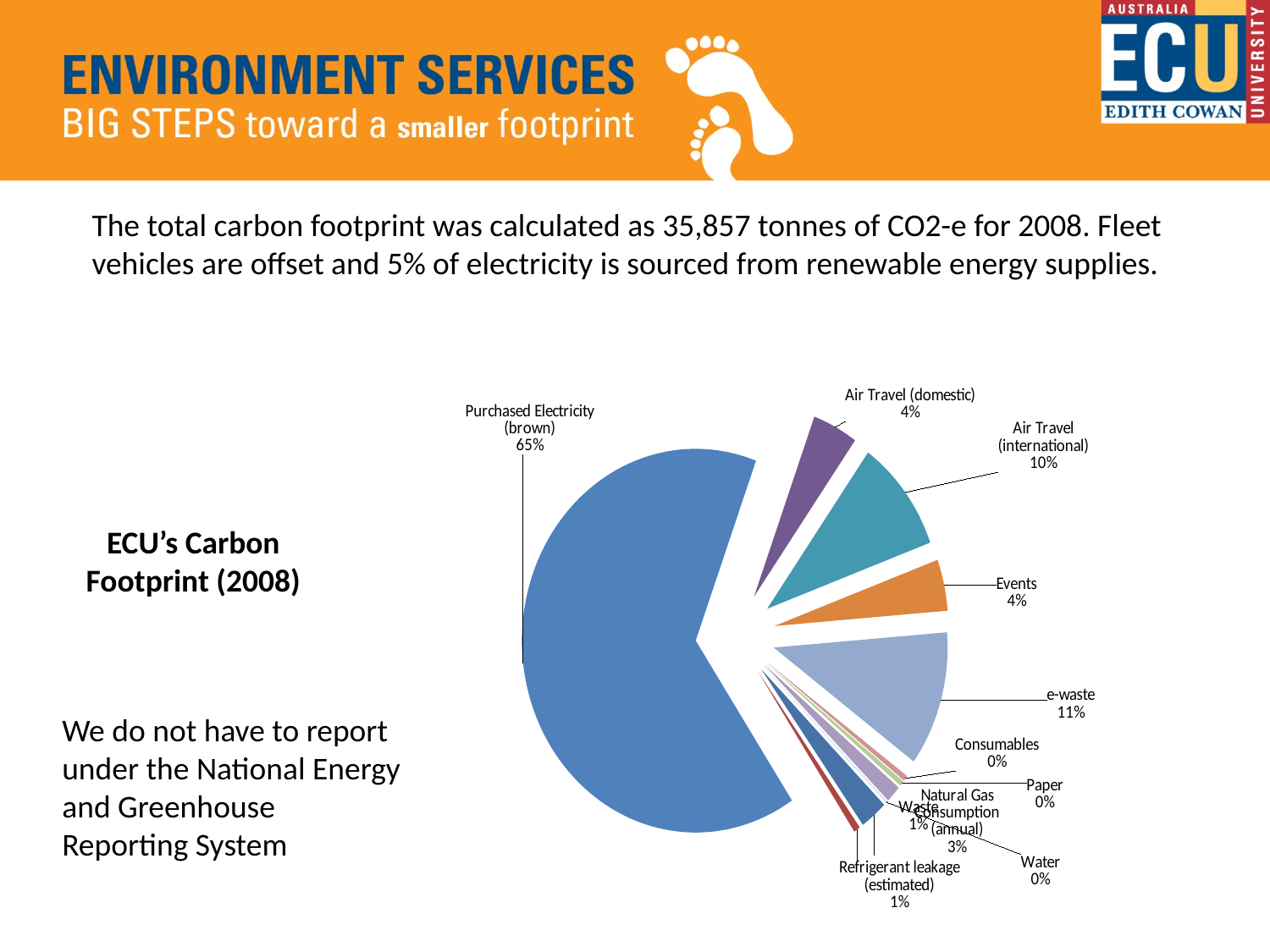
What share is labelled for Natural Gas consumption (annual)? 3% What is the title of the pie chart? ECU's Carbon Footprint (2008) What share of ECU's carbon footprint comes from Purchased Electricity (brown)? 65% Which category has the largest slice of the pie? Purchased Electricity (brown) What percentage of the pie is e-waste? 11% Which is larger, the share for e-waste or the share for Air Travel (international)? e-waste What is the difference in percentage points between Purchased Electricity (brown) and e-waste? 54 What percentage is shown for Events? 4% What kind of chart is shown on the slide? pie chart What share does Air Travel (international) account for? 10% How many categories are shown in the pie chart? 11 What is the difference in percentage points between Air Travel (international) and Air Travel (domestic)? 6